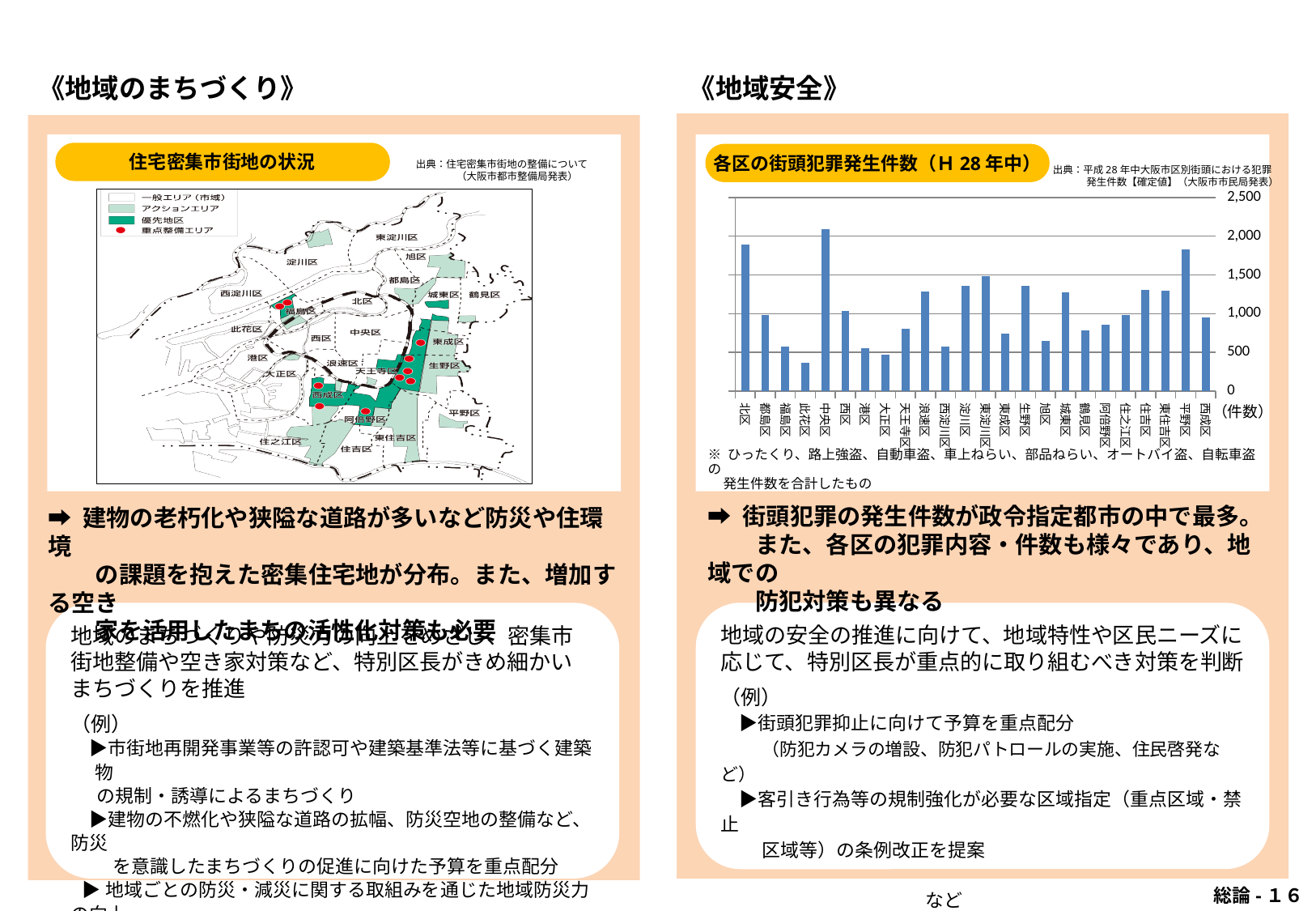
In the 各区の街頭犯罪発生件数 chart, which ward has the highest number of street crimes? 中央区 In the 各区の街頭犯罪発生件数 chart, is the value for 平野区 greater or less than 1,500? greater What unit label is shown next to the vertical axis of the 各区の街頭犯罪発生件数 chart? （件数） In the 各区の街頭犯罪発生件数 chart, is the value for 中央区 greater or less than 2,000? greater What kind of chart is shown under 《地域安全》 on the slide? bar chart In the 各区の街頭犯罪発生件数 chart, which ward has the lowest number of street crimes? 此花区 In the 各区の街頭犯罪発生件数 chart, which ward has more street crimes, 北区 or 都島区? 北区 What is the title of the bar chart on the right side of the slide? 各区の街頭犯罪発生件数（H28年中） How many wards (categories) are plotted in the 各区の街頭犯罪発生件数 bar chart? 24 In the 各区の街頭犯罪発生件数 chart, is the value for 東成区 greater or less than 1,000? less In the 各区の街頭犯罪発生件数 chart, which ward has more street crimes, 福島区 or 浪速区? 浪速区